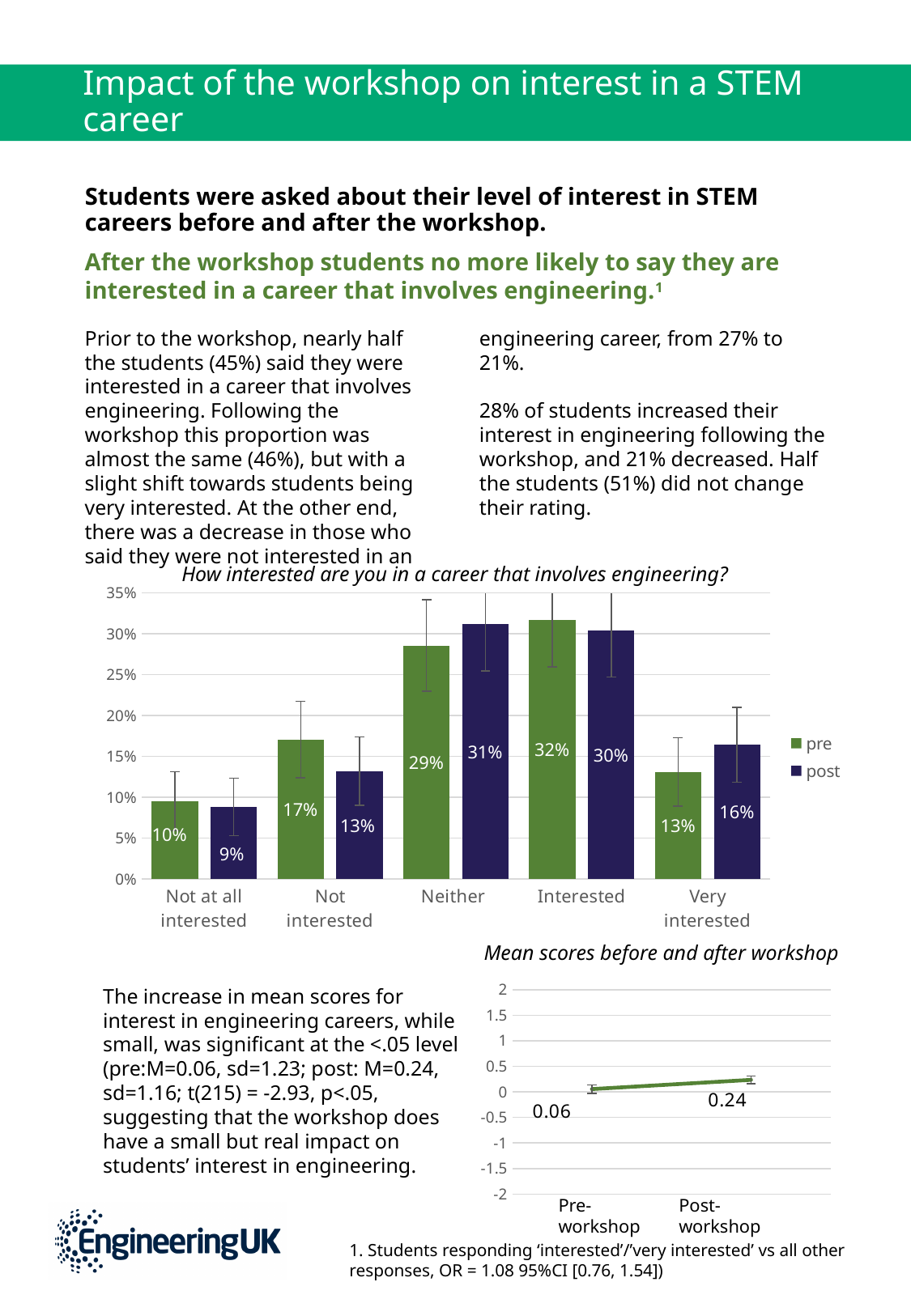
In the chart 'How interested are you in a career that involves engineering?', what is the difference between the pre and post values for 'Not interested'? 4% In the chart 'How interested are you in a career that involves engineering?', what is the post value for 'Very interested'? 16% In the chart 'Mean scores before and after workshop', what is the value for Post-workshop? 0.24 In the chart 'How interested are you in a career that involves engineering?', which category has the lowest post value? Not at all interested In the chart 'Mean scores before and after workshop', does the value rise or fall from Pre-workshop to Post-workshop? rise In the chart 'How interested are you in a career that involves engineering?', is the pre value or the post value larger for 'Neither'? post In the chart 'How interested are you in a career that involves engineering?', how many series does the legend list? 2 In the chart 'How interested are you in a career that involves engineering?', which category has the highest pre value? Interested In the chart 'How interested are you in a career that involves engineering?', what is the pre value for 'Neither'? 29% What kind of chart is 'How interested are you in a career that involves engineering?'? bar chart In the chart 'How interested are you in a career that involves engineering?', how many categories are shown on the x axis? 5 In the chart 'Mean scores before and after workshop', what is the difference between the Post-workshop and Pre-workshop values? 0.18